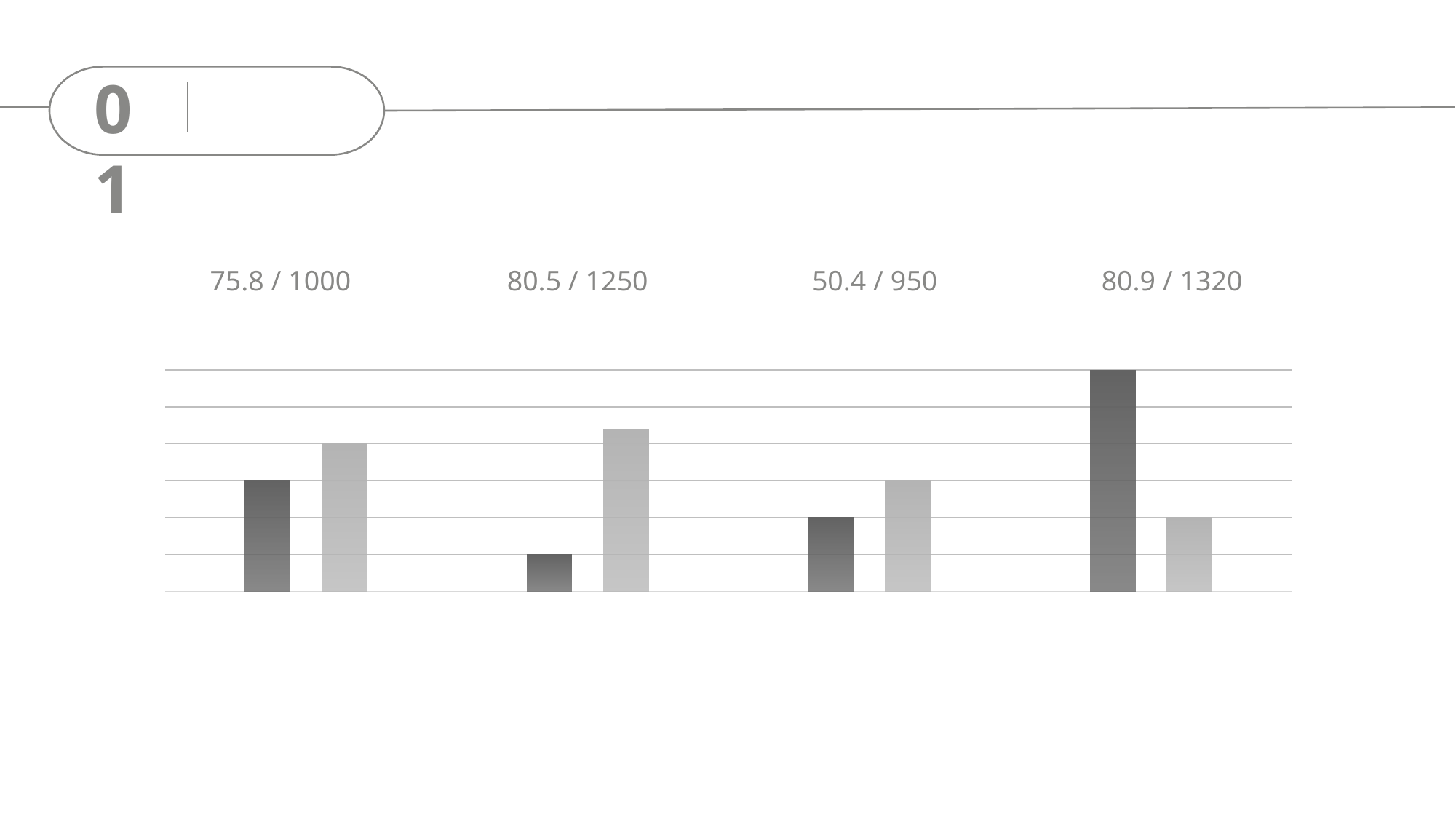
Which group (by position from the left) has the shortest dark bar? the second group In the first group from the left, which bar is taller, the dark one or the light one? the light one What text is printed above the first group of bars? 75.8 / 1000 How many bars are plotted in total on the chart? 8 What kind of chart is shown on the slide? bar chart Which group (by position from the left) has the tallest light bar? the second group What text is printed above the rightmost group of bars? 80.9 / 1320 How many bars are there in each group? 2 How many groups of bars does the chart contain? 4 Which group (by position from the left) has the shortest light bar? the fourth (rightmost) group In the fourth group from the left, which bar is taller, the dark one or the light one? the dark one Which group (by position from the left) has the tallest dark bar? the fourth (rightmost) group